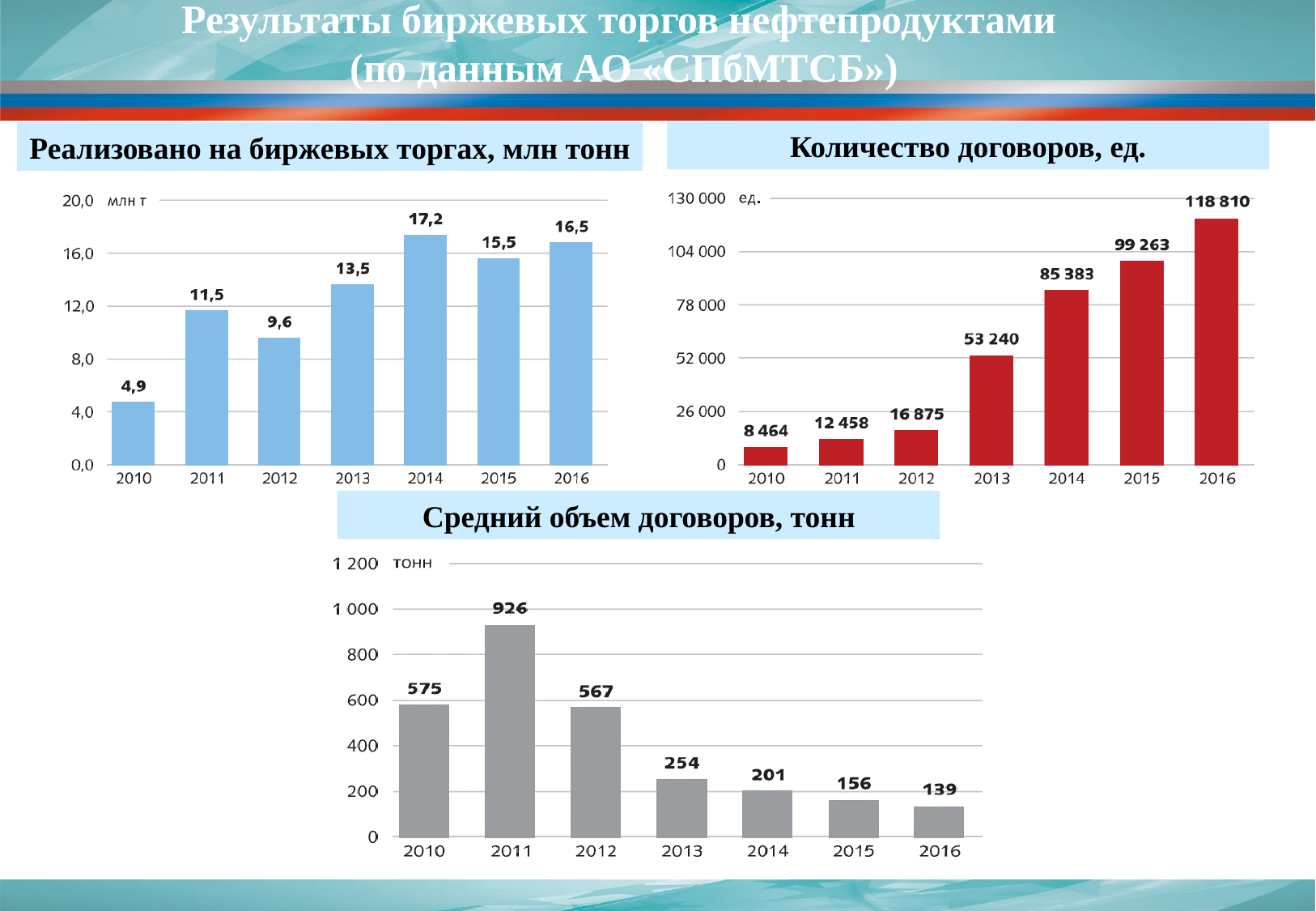
In the chart 'Количество договоров, ед.', how many years are shown on the x axis? 7 In the chart 'Количество договоров, ед.', do the values rise or fall from 2010 to 2016? rise In the chart 'Реализовано на биржевых торгах, млн тонн', which year has the lowest value? 2010 In the chart 'Средний объем договоров, тонн', what is the difference between the values for 2010 and 2012? 8 In the chart 'Реализовано на биржевых торгах, млн тонн', what is the value for 2014? 17,2 In the chart 'Средний объем договоров, тонн', what is the value for 2011? 926 In the chart 'Количество договоров, ед.', what is the value for 2013? 53 240 In the chart 'Средний объем договоров, тонн', which year has the lowest value? 2016 In the chart 'Реализовано на биржевых торгах, млн тонн', which is larger, the value for 2011 or the value for 2012? 2011 In the chart 'Реализовано на биржевых торгах, млн тонн', what is the difference between the values for 2016 and 2015? 1,0 What type of chart is 'Средний объем договоров, тонн'? bar chart In the chart 'Количество договоров, ед.', which year has the highest value? 2016